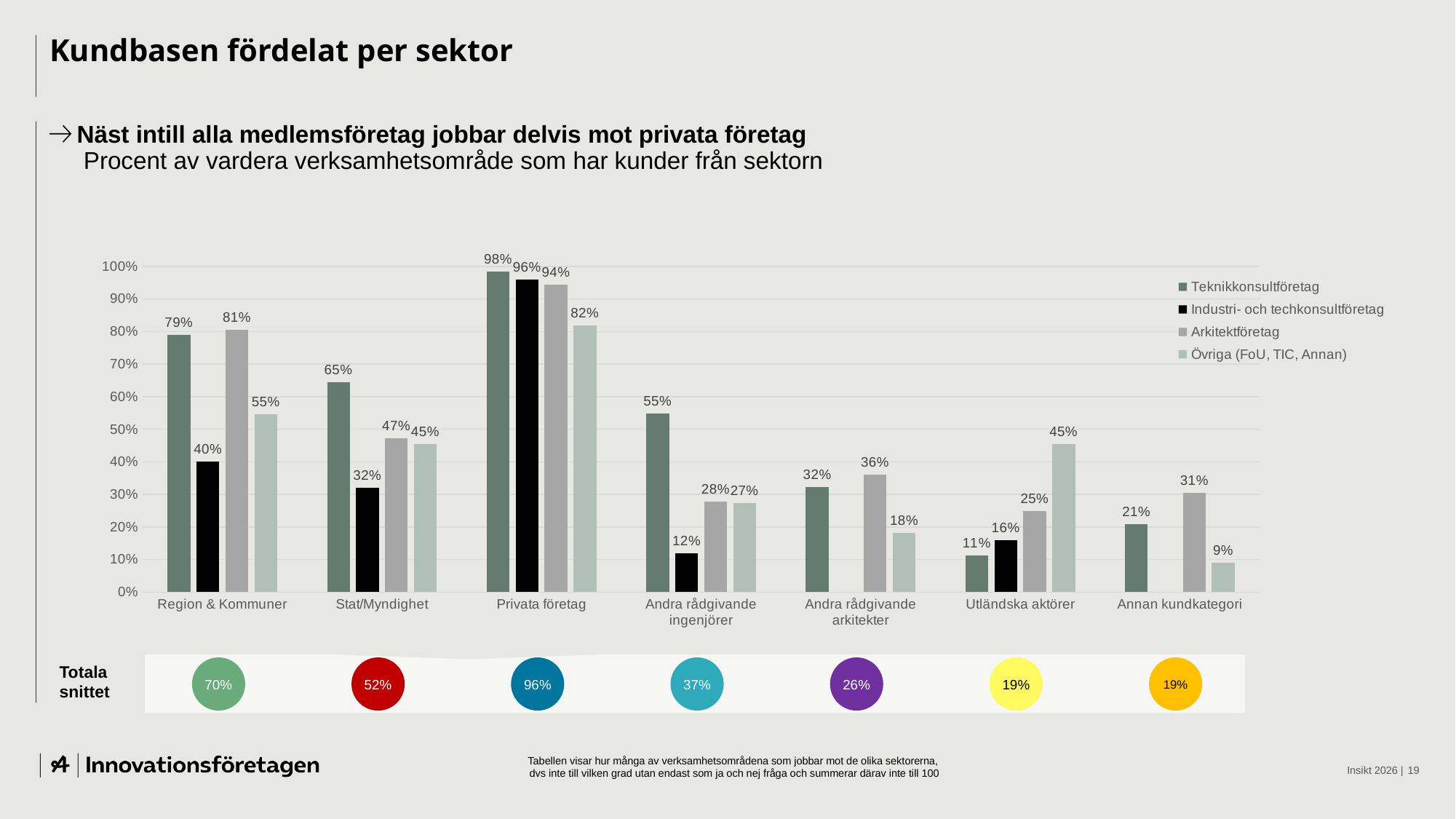
Which category has the lowest value for Teknikkonsultföretag? Utländska aktörer What is the Totala snittet value shown for Privata företag? 96% What is the value for Teknikkonsultföretag in the Privata företag category? 98% What kind of chart is shown on the slide? bar chart What is the value for Övriga (FoU, TIC, Annan) in the Utländska aktörer category? 45% In the Andra rådgivande arkitekter category, which is larger: Arkitektföretag or Övriga (FoU, TIC, Annan)? Arkitektföretag Which category has the highest value for Arkitektföretag? Privata företag Which series is shown in black in the legend? Industri- och techkonsultföretag What is the difference between the Teknikkonsultföretag and Industri- och techkonsultföretag values in the Stat/Myndighet category? 33% What is the value for Industri- och techkonsultföretag in the Region & Kommuner category? 40% How many customer categories are shown on the x axis? 7 How many series does the legend list? 4